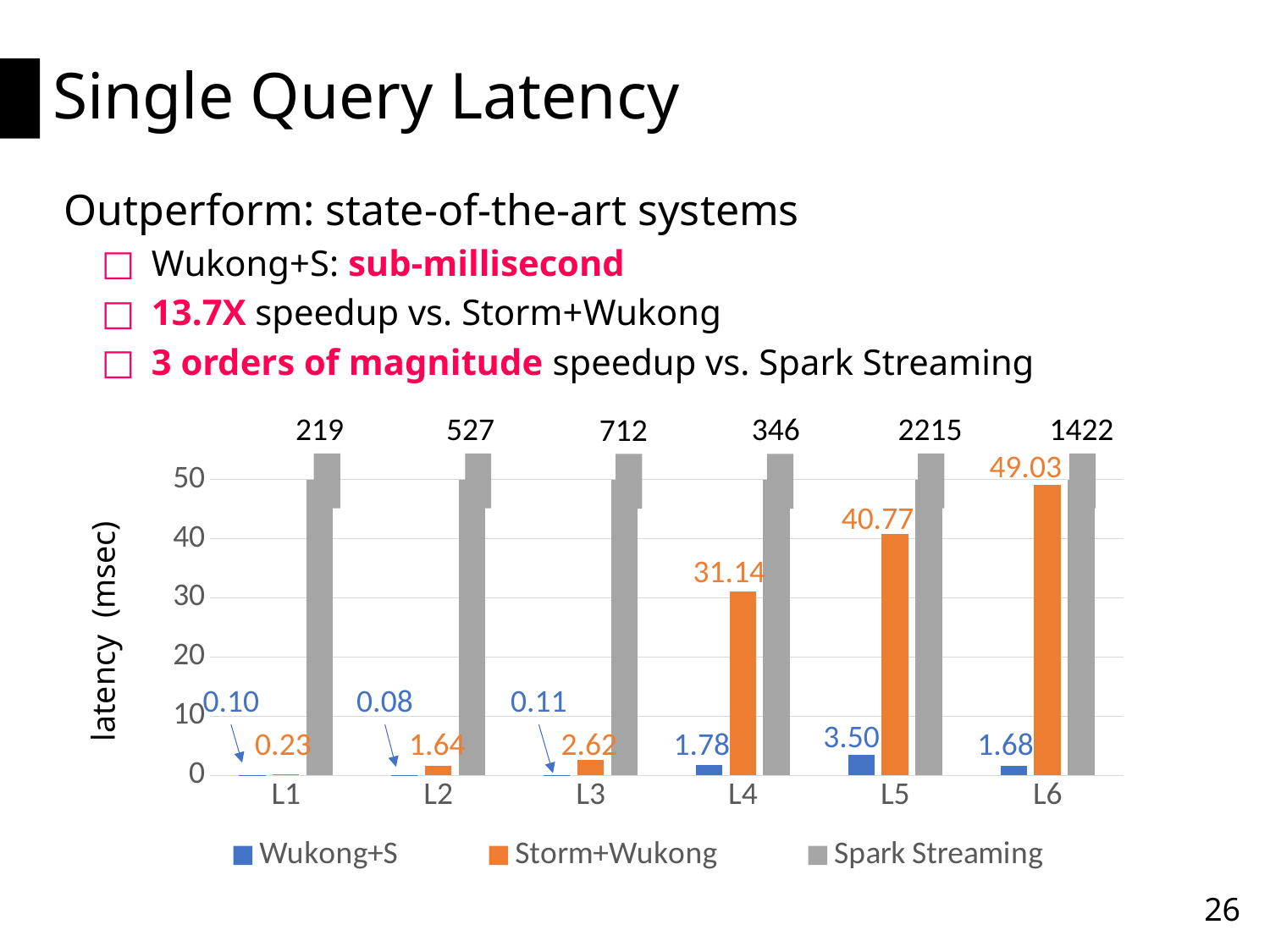
What kind of chart is shown? bar chart What is the label of the y axis? latency (msec) What is the Spark Streaming latency for L5? 2215 Which is larger, the Wukong+S latency for L5 or for L4? L5 Which query has the lowest Spark Streaming latency? L1 Which query has the highest Storm+Wukong latency? L6 How many series does the legend list? 3 What is the Wukong+S latency for L2? 0.08 Is the Storm+Wukong latency for L5 greater or less than 40? greater How many queries are shown on the x axis? 6 What is the difference between the Spark Streaming latency for L6 and for L3? 710 What is the Storm+Wukong latency for L4? 31.14